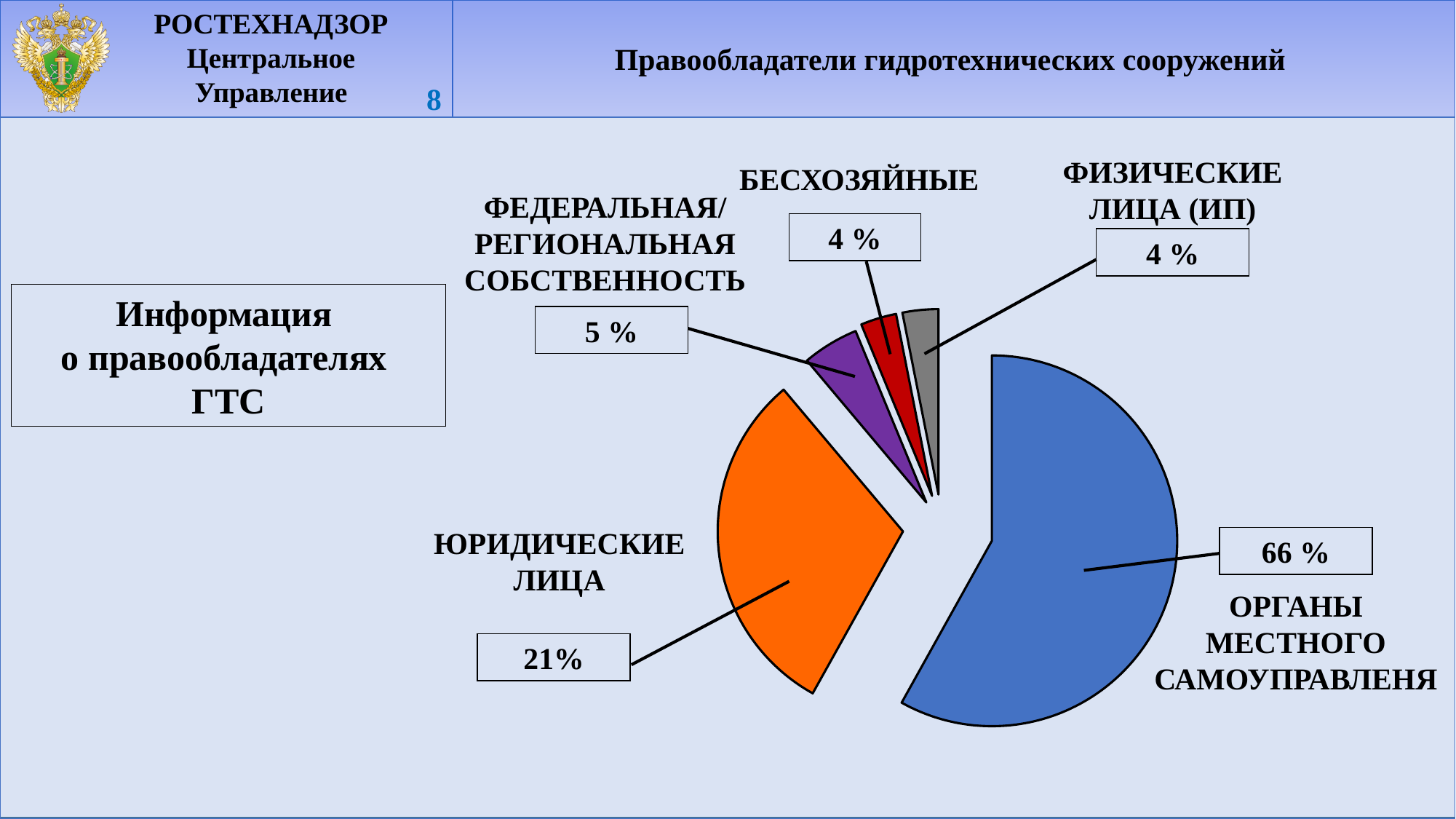
What percentage is shown for ФЕДЕРАЛЬНАЯ/РЕГИОНАЛЬНАЯ СОБСТВЕННОСТЬ? 5 % What is the title of the slide containing the pie chart? Правообладатели гидротехнических сооружений What type of chart is shown on the slide? Pie chart What percentage is shown for БЕСХОЗЯЙНЫЕ? 4 % What colour is the slice for ЮРИДИЧЕСКИЕ ЛИЦА? Orange What share of the pie chart is labelled ОРГАНЫ МЕСТНОГО САМОУПРАВЛЕНЯ? 66 % How many slices does the pie chart have? 5 Which is larger: the slice for ЮРИДИЧЕСКИЕ ЛИЦА or the slice for ФЕДЕРАЛЬНАЯ/РЕГИОНАЛЬНАЯ СОБСТВЕННОСТЬ? ЮРИДИЧЕСКИЕ ЛИЦА Which category has the largest slice of the pie chart? ОРГАНЫ МЕСТНОГО САМОУПРАВЛЕНЯ What percentage is shown for ФИЗИЧЕСКИЕ ЛИЦА (ИП)? 4 % What is the difference in percentage points between ОРГАНЫ МЕСТНОГО САМОУПРАВЛЕНЯ and ЮРИДИЧЕСКИЕ ЛИЦА? 45 What percentage is shown for ЮРИДИЧЕСКИЕ ЛИЦА? 21%